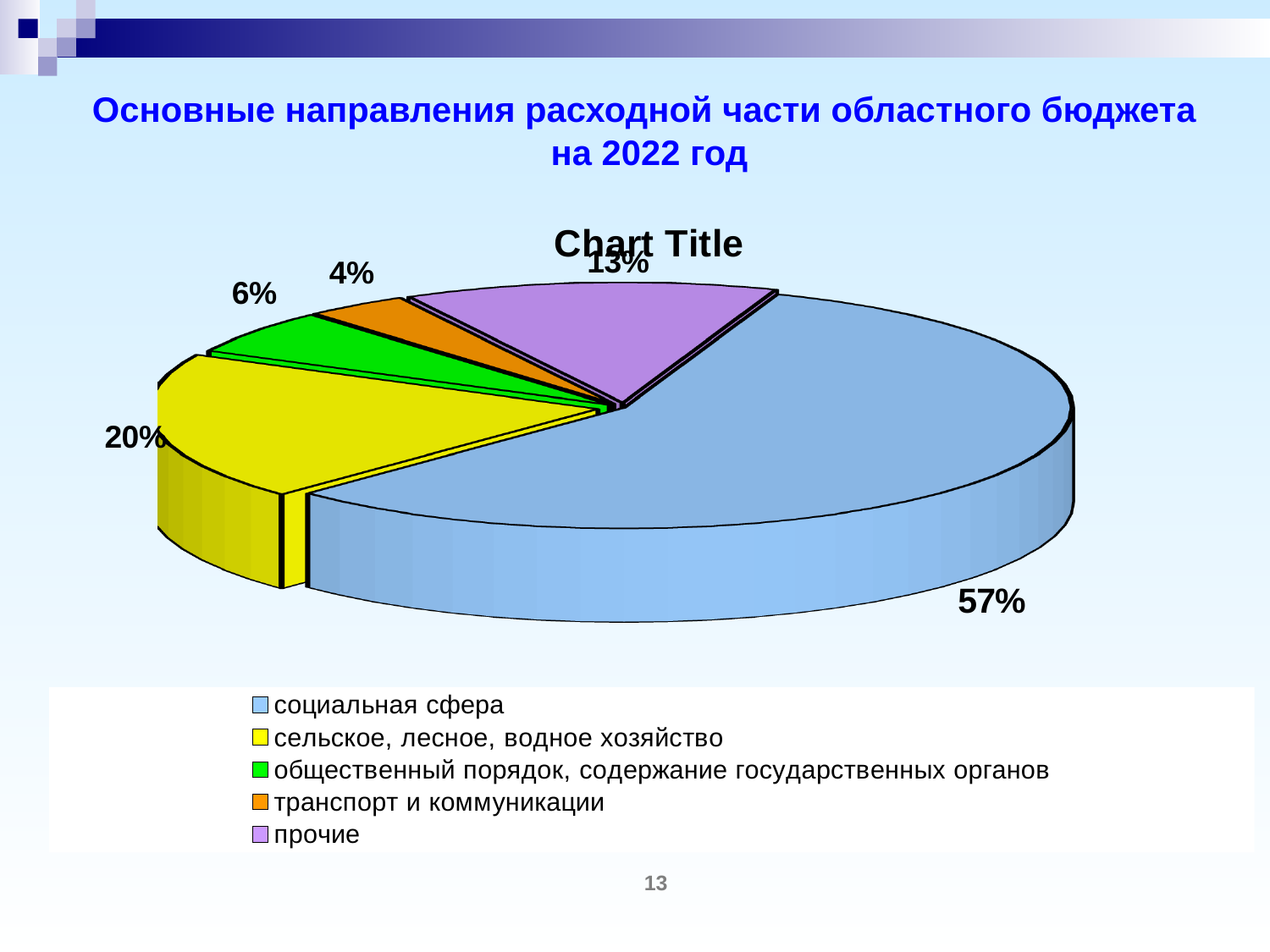
What colour is the slice for сельское, лесное, водное хозяйство? yellow How many slices does the pie chart have? 5 What percentage is shown for сельское, лесное, водное хозяйство? 20% What percentage is shown for общественный порядок, содержание государственных органов? 6% What is the value labelled for прочие? 13% What share of the pie does социальная сфера account for? 57% Which is larger, the slice for прочие or the slice for общественный порядок, содержание государственных органов? прочие Which category has the smallest slice of the pie? транспорт и коммуникации What is the difference in percentage points between социальная сфера and сельское, лесное, водное хозяйство? 37 What type of chart is shown on the slide? pie chart Which category has the largest slice of the pie? социальная сфера What percentage is shown for транспорт и коммуникации? 4%